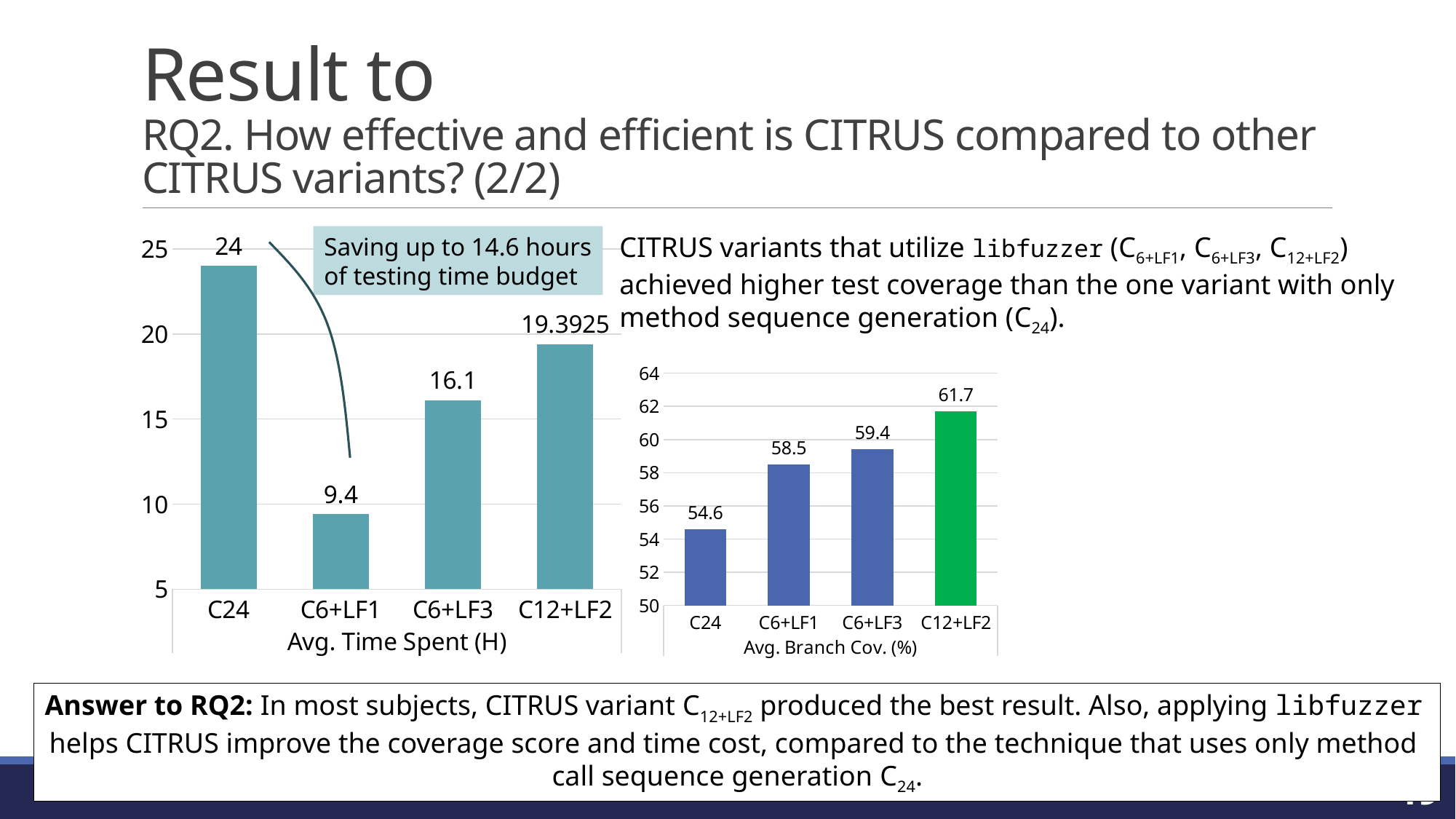
In the Avg. Time Spent (H) chart, which category has the lowest value? C6+LF1 In the Avg. Branch Cov. (%) chart, what is the value for C6+LF3? 59.4 In the Avg. Branch Cov. (%) chart, which category has the highest value? C12+LF2 In the Avg. Branch Cov. (%) chart, which category has the lowest value? C24 How many categories are shown in the Avg. Time Spent (H) chart? 4 In the Avg. Time Spent (H) chart, what is the difference between C24 and C6+LF1? 14.6 In the Avg. Time Spent (H) chart, what is the value for C12+LF2? 19.3925 In the Avg. Time Spent (H) chart, which category has the highest value? C24 In the Avg. Branch Cov. (%) chart, what is the difference between C12+LF2 and C24? 7.1 What type of chart is the Avg. Branch Cov. (%) chart? Bar chart In the Avg. Time Spent (H) chart, what is the value for C6+LF1? 9.4 In the Avg. Branch Cov. (%) chart, which is larger, C6+LF1 or C6+LF3? C6+LF3